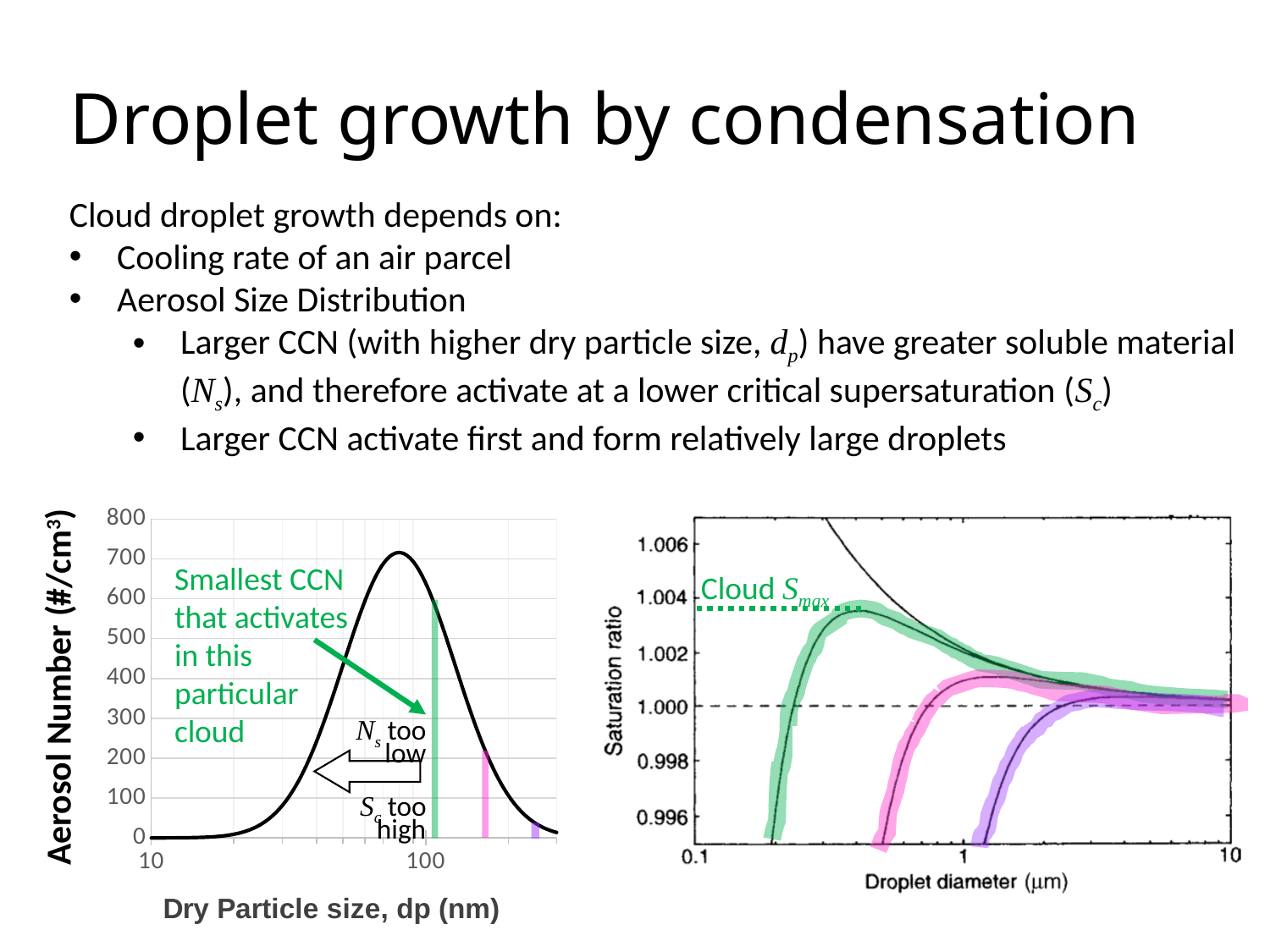
On the right chart, does the green curve rise or fall as droplet diameter increases from about 0.5 µm to 10 µm? fall On the left chart, how many coloured vertical bars are drawn under the black curve? 3 What is the y-axis title of the right chart? Saturation ratio What is the x-axis title of the left chart? Dry Particle size, dp (nm) On the right chart, which coloured curve reaches the highest saturation ratio? green What kind of chart is the left chart, showing Aerosol Number against Dry Particle size? line chart On the left chart, which of the three coloured vertical bars is the shortest? purple On the left chart, is the peak of the black curve greater or less than 600 #/cm³? greater On the right chart, is the peak saturation ratio of the green curve greater or less than 1.002? greater On the left chart, is the height of the green vertical bar greater or less than 500 #/cm³? greater On the left chart, which of the three coloured vertical bars is the tallest? green